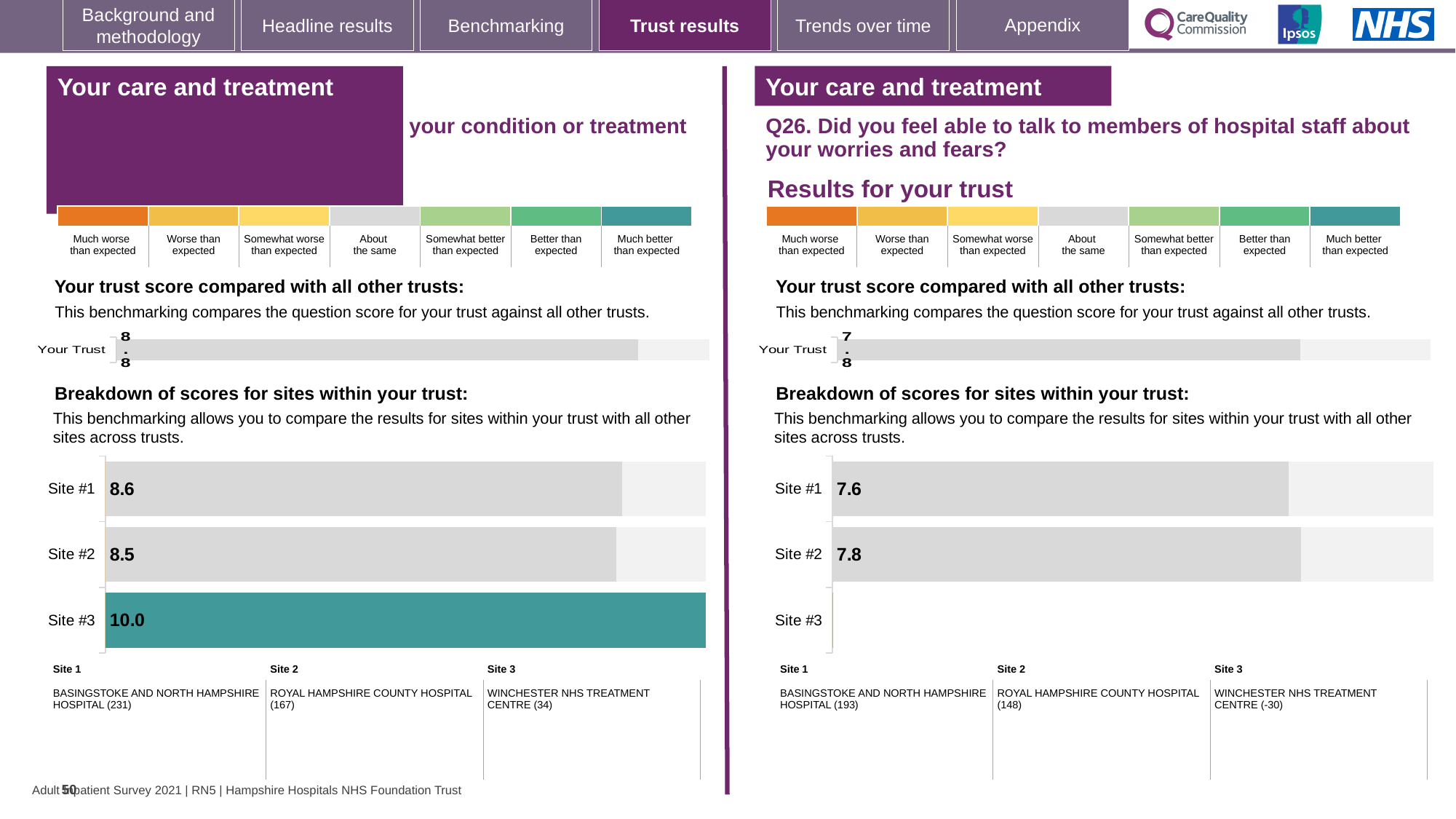
On the Q26 'Your trust score compared with all other trusts' chart on the right, what is the value shown for Your Trust? 7.8 On the left-hand 'Breakdown of scores for sites within your trust' chart, what is the score for Site #3? 10.0 On the Q26 'Breakdown of scores for sites within your trust' chart on the right, what is the score for Site #2? 7.8 On the left-hand 'Your trust score compared with all other trusts' chart, what is the value shown for Your Trust? 8.8 On the Q26 'Breakdown of scores for sites within your trust' chart on the right, what is the difference between the scores for Site #2 and Site #1? 0.2 On the left-hand 'Breakdown of scores for sites within your trust' chart, which site has the lowest score? Site #2 On the left-hand 'Breakdown of scores for sites within your trust' chart, which site has the highest score? Site #3 On the left-hand 'Breakdown of scores for sites within your trust' chart, what is the score for Site #1? 8.6 What kind of chart is the 'Breakdown of scores for sites within your trust' chart on the left? Bar chart On the Q26 'Breakdown of scores for sites within your trust' chart on the right, what is the score for Site #1? 7.6 On the left-hand 'Breakdown of scores for sites within your trust' chart, what is the difference between the scores for Site #3 and Site #2? 1.5 On the Q26 'Breakdown of scores for sites within your trust' chart on the right, which has the higher score, Site #1 or Site #2? Site #2